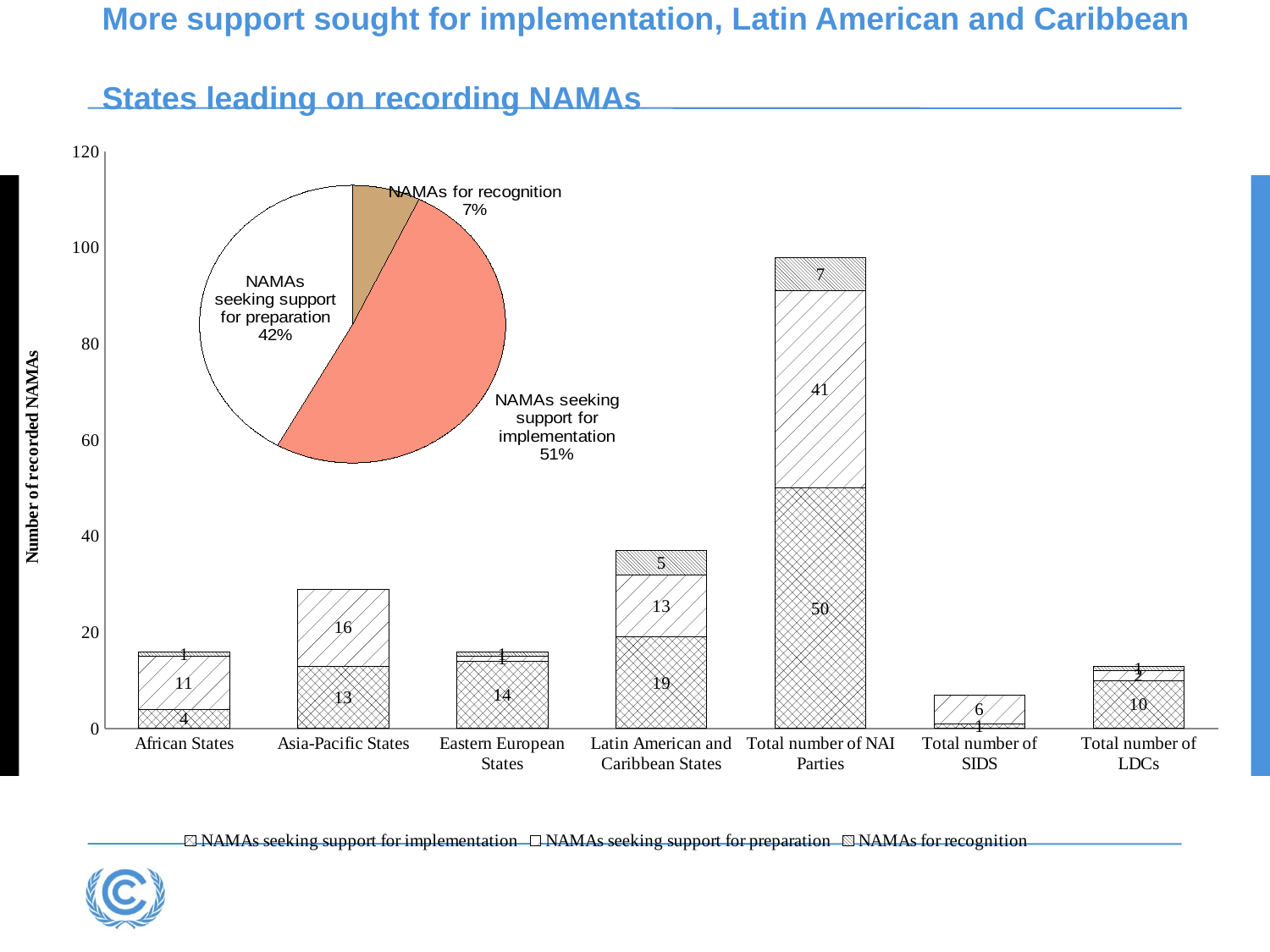
In the bar chart, what is the number of NAMAs seeking support for preparation for Asia-Pacific States? 16 In the pie chart, which slice is the smallest? NAMAs for recognition In the pie chart, what share of NAMAs are seeking support for implementation? 51% In the bar chart, what is the total height of the stacked bar for Total number of NAI Parties? 98 In the bar chart, what is the number of NAMAs seeking support for implementation for Total number of NAI Parties? 50 In the pie chart, which slice is the largest? NAMAs seeking support for implementation In the bar chart, what is the total height of the stacked bar for Latin American and Caribbean States? 37 In the bar chart, what is the number of NAMAs for recognition for Latin American and Caribbean States? 5 How many categories are shown on the x axis of the bar chart? 7 In the bar chart, which has more NAMAs seeking support for implementation: Latin American and Caribbean States or Asia-Pacific States? Latin American and Caribbean States How many series does the legend of the bar chart list? 3 In the bar chart, what is the difference between the NAMAs seeking support for preparation for Total number of NAI Parties and for Latin American and Caribbean States? 28